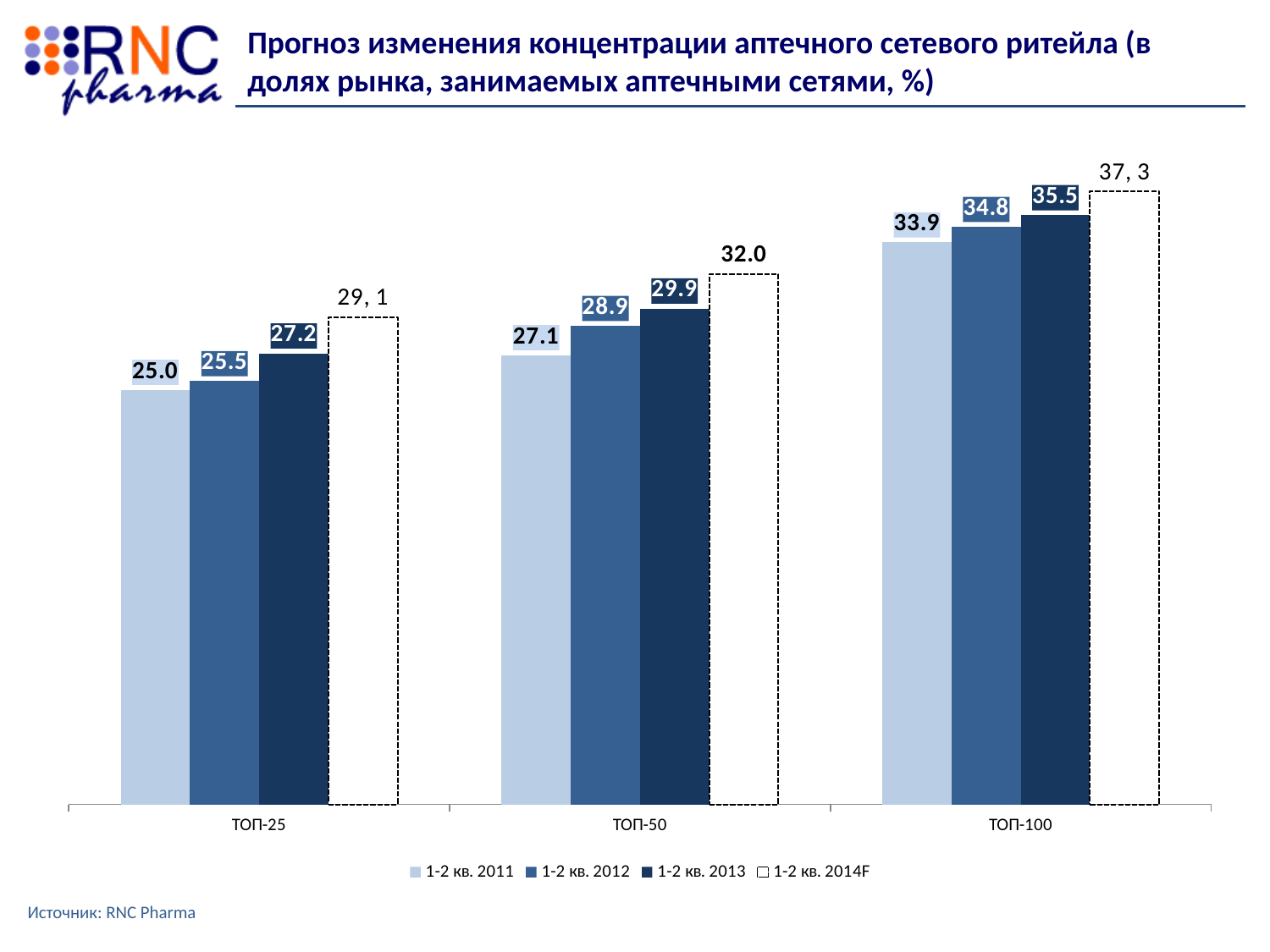
How many categories are shown on the x axis? 3 Which is larger: the 1-2 кв. 2012 value for ТОП-50 or the 1-2 кв. 2013 value for ТОП-25? 1-2 кв. 2012 value for ТОП-50 What is the difference between the 1-2 кв. 2013 and 1-2 кв. 2011 values for ТОП-100? 1.6 Which category has the lowest value in 1-2 кв. 2011? ТОП-25 What is the forecast value for ТОП-50 in 1-2 кв. 2014F? 32.0 Do the values for ТОП-25 rise or fall from 1-2 кв. 2011 to 1-2 кв. 2014F? rise How many series does the legend list? 4 What is the value for ТОП-25 in 1-2 кв. 2011? 25.0 What type of chart is shown on the slide? bar chart Which category has the highest value in 1-2 кв. 2013? ТОП-100 What is the value for ТОП-50 in 1-2 кв. 2013? 29.9 What is the value for ТОП-100 in 1-2 кв. 2012? 34.8